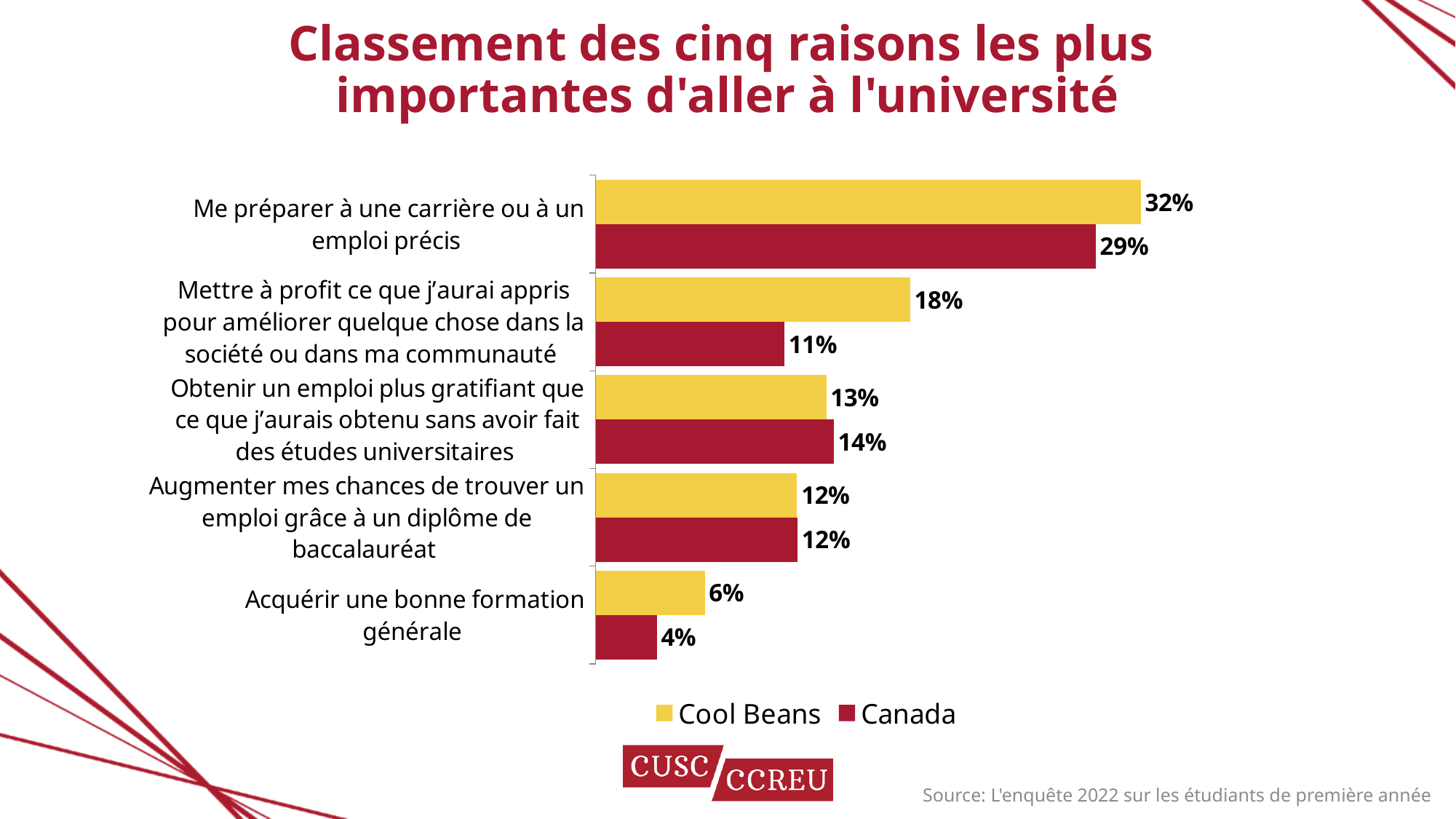
What kind of chart is shown on the slide? Bar chart What is the difference between the Cool Beans and Canada values for "Mettre à profit ce que j'aurai appris pour améliorer quelque chose dans la société ou dans ma communauté"? 7% What is the Cool Beans value for "Me préparer à une carrière ou à un emploi précis"? 32% Which category has the highest Cool Beans value? Me préparer à une carrière ou à un emploi précis How many categories are shown in the chart? 5 Which category has the lowest Canada value? Acquérir une bonne formation générale What is the difference between the Cool Beans and Canada values for "Me préparer à une carrière ou à un emploi précis"? 3% For "Obtenir un emploi plus gratifiant que ce que j'aurais obtenu sans avoir fait des études universitaires", which series has the larger value, Cool Beans or Canada? Canada Which colour represents the Canada series in the chart? Red What is the Canada value for "Mettre à profit ce que j'aurai appris pour améliorer quelque chose dans la société ou dans ma communauté"? 11% What is the Canada value for "Acquérir une bonne formation générale"? 4% How many series does the legend list? 2